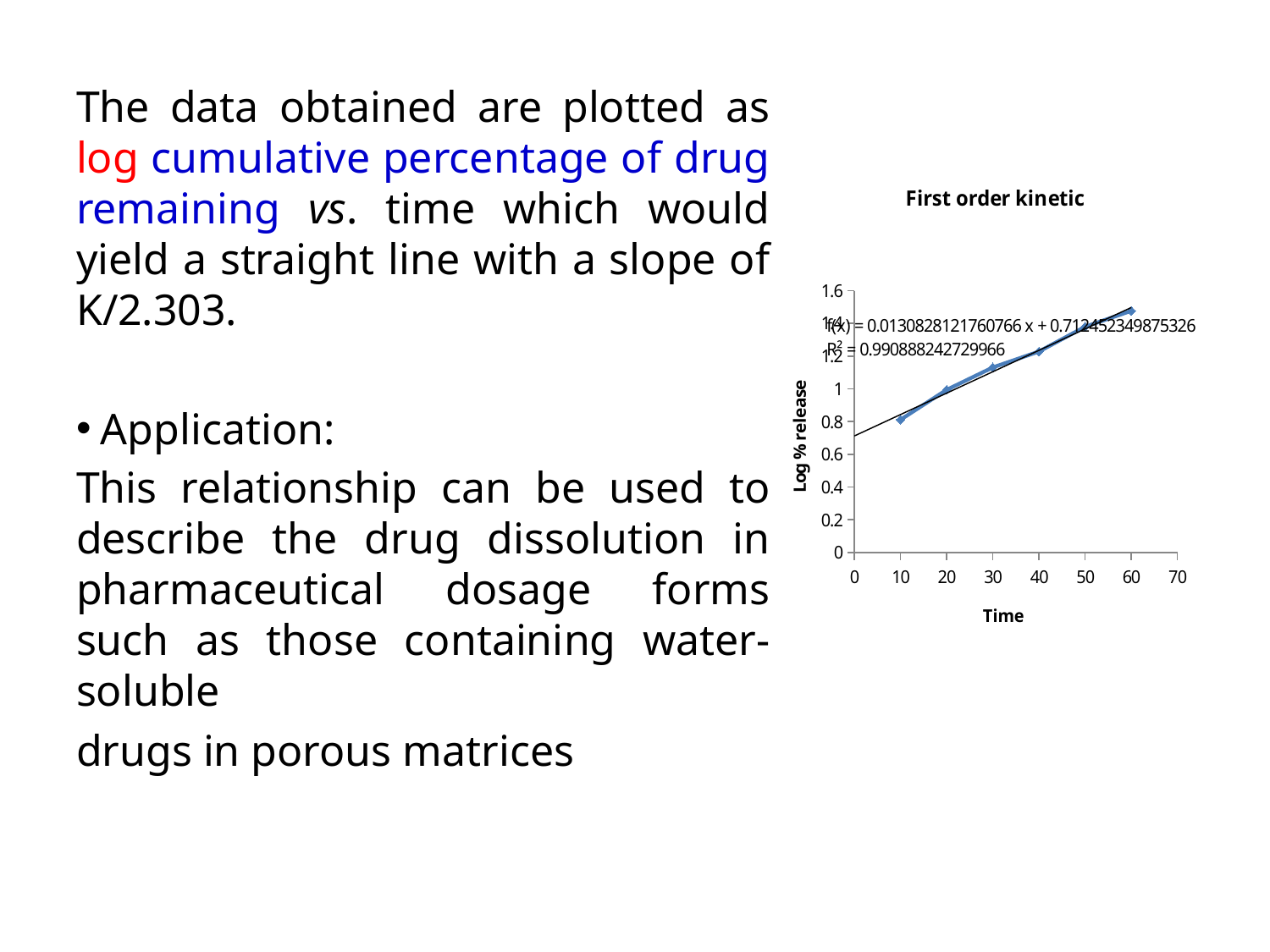
What is the title of the chart? First order kinetic How many data points are plotted on the chart? 6 What is the highest value shown on the Time axis? 70 Do the plotted values rise or fall as Time increases? rise At which Time value is the plotted Log % release highest? 60 What label is shown on the y axis of the chart? Log % release Which has the larger Log % release, Time 10 or Time 40? Time 40 What kind of chart is shown on the slide? line chart Is the Log % release at Time 60 greater or less than 1.2? greater At which Time value is the plotted Log % release lowest? 10 Is the Log % release at Time 40 greater or less than 1? greater Is the Log % release at Time 10 greater or less than 1? less